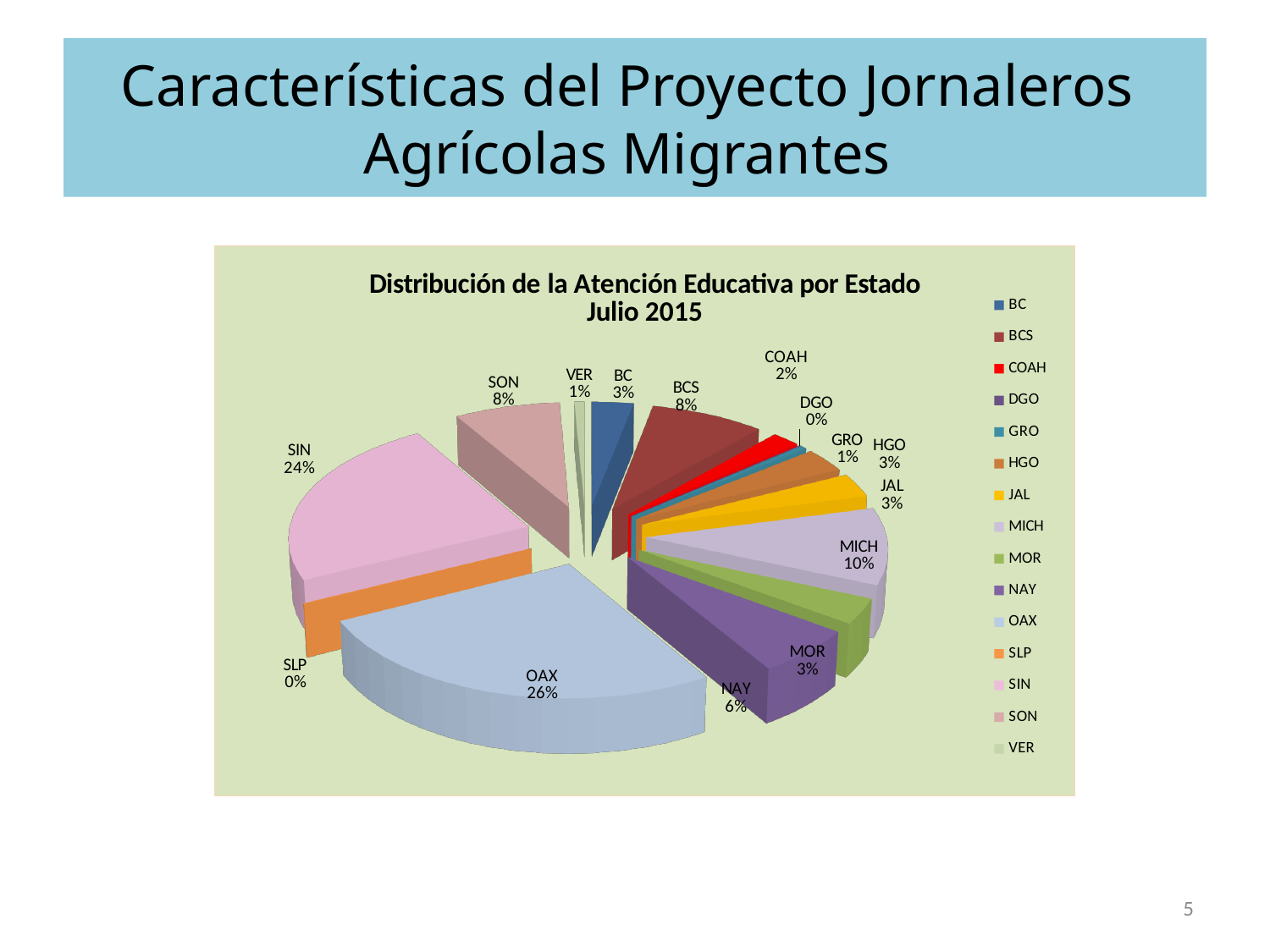
Which is larger, the share for MICH or the share for NAY? MICH How many states are listed in the legend? 15 Which is larger, the share for BCS or the share for SON? They are equal (8%) What is the value shown for NAY? 6% What is the title of the chart? Distribución de la Atención Educativa por Estado Julio 2015 What share of the pie does OAX have? 26% What share of the pie does SIN have? 24% What is the value shown for MICH? 10% What is the difference between the shares of OAX and SIN? 2% What is the value shown for COAH? 2% Which state has the largest share of the pie? OAX What type of chart is shown on the slide? Pie chart